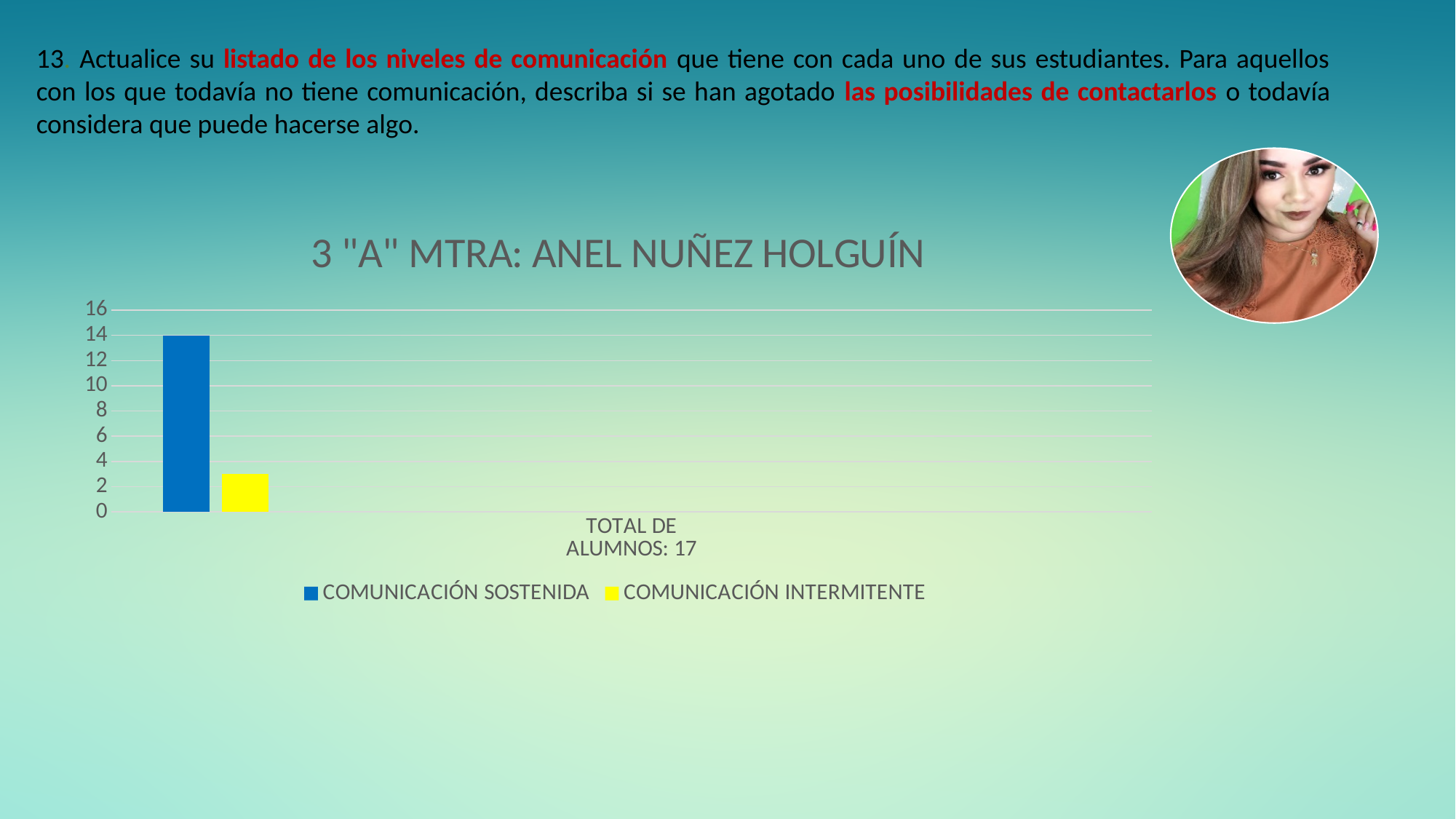
Is the value for COMUNICACIÓN INTERMITENTE greater or less than 2? greater What kind of chart is shown on the slide? bar chart How many series does the chart legend list? 2 What is the title of the chart? 3 "A" MTRA: ANEL NUÑEZ HOLGUÍN What colour is the COMUNICACIÓN INTERMITENTE series in the chart? yellow Is the value for COMUNICACIÓN INTERMITENTE greater or less than 4? less Which is larger, the COMUNICACIÓN SOSTENIDA bar or the COMUNICACIÓN INTERMITENTE bar? COMUNICACIÓN SOSTENIDA Is the value for COMUNICACIÓN SOSTENIDA greater or less than 10? greater What is the value of the COMUNICACIÓN SOSTENIDA bar? 14 Which series has the highest bar in the chart? COMUNICACIÓN SOSTENIDA Which series has the lowest bar in the chart? COMUNICACIÓN INTERMITENTE